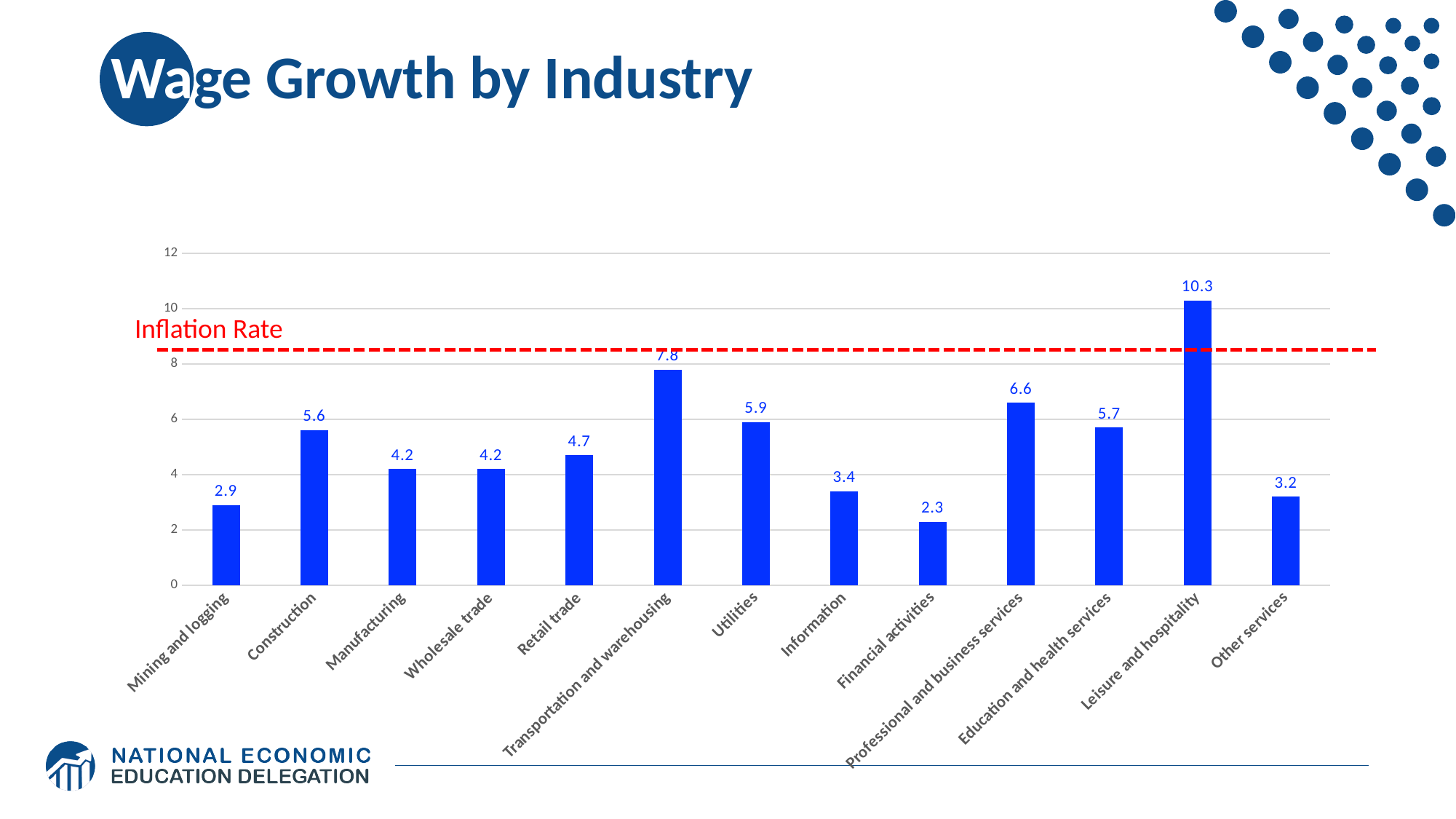
Which industry's bar is the only one above the Inflation Rate line? Leisure and hospitality What is the wage growth value for Construction? 5.6 What is the wage growth value for Transportation and warehousing? 7.8 Which industry has the lowest wage growth? Financial activities Which industry has the highest wage growth? Leisure and hospitality What is the wage growth value for Financial activities? 2.3 What kind of chart is shown on the slide? Bar chart Is the value for Professional and business services greater or less than 6? greater Which has higher wage growth, Utilities or Education and health services? Utilities How many industries are shown in the chart? 13 What does the red dashed line on the chart represent? Inflation Rate What is the difference between the wage growth for Leisure and hospitality and for Transportation and warehousing? 2.5